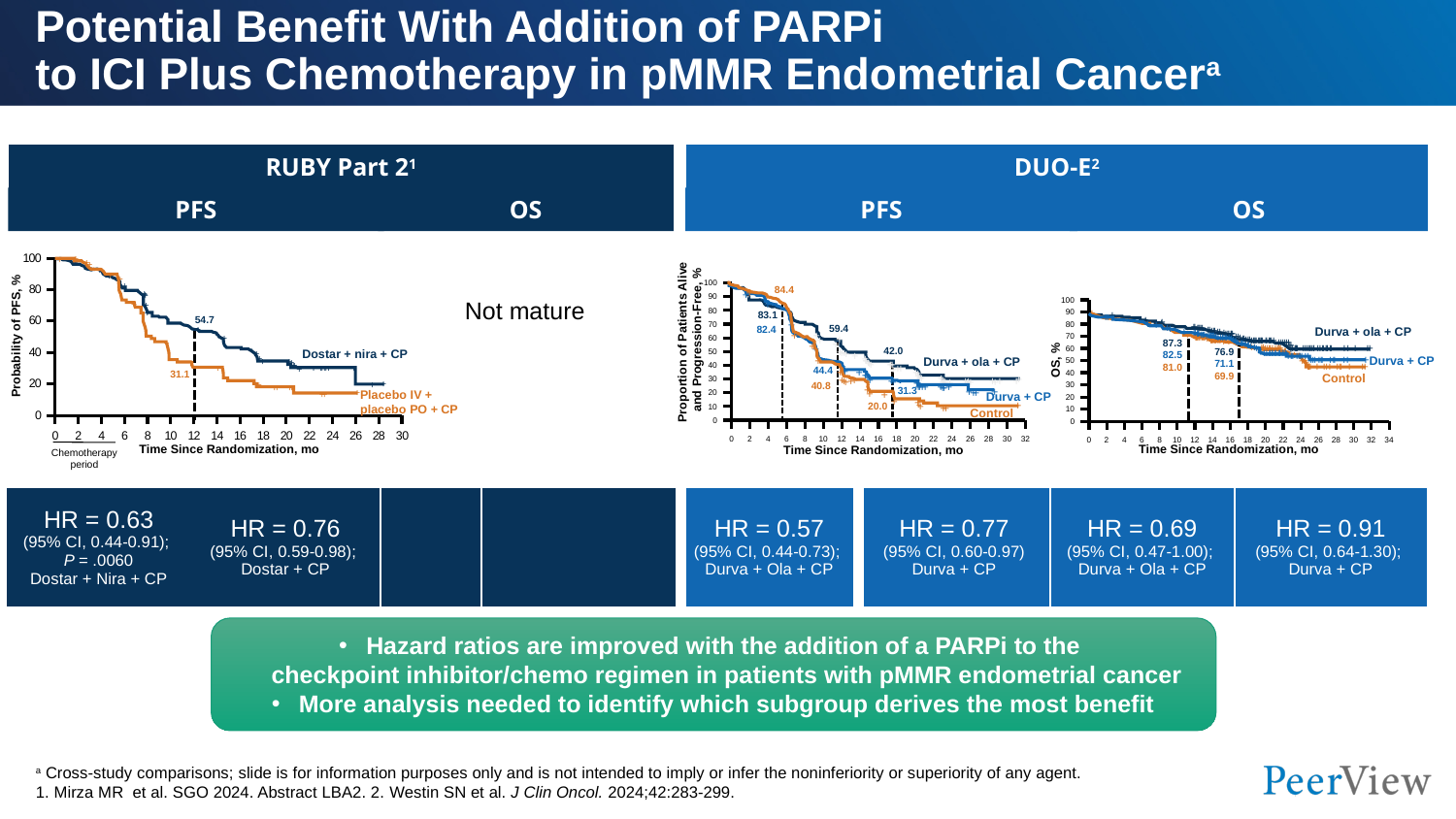
What is the x-axis label of the DUO-E OS chart? Time Since Randomization, mo In the RUBY Part 2 PFS chart, what is the difference between the labeled values 54.7 and 31.1? 23.6 How many treatment arms are plotted in the DUO-E PFS chart? 3 In the DUO-E PFS chart, what is the labeled value for the Control arm at the 18-month dashed line? 20.0 What kind of chart is the RUBY Part 2 PFS chart? Line chart (Kaplan-Meier curve) In the DUO-E OS chart, what is the labeled OS value for the Control arm at the second dashed line? 69.9 In the RUBY Part 2 PFS chart, which arm has the higher labeled PFS value at the dashed line, Dostar + nira + CP or Placebo IV + placebo PO + CP? Dostar + nira + CP In the RUBY Part 2 PFS chart, what is the labeled probability of PFS for the Dostar + nira + CP arm at the dashed line? 54.7 In the DUO-E PFS chart, what is the difference between the Durva + ola + CP value (59.4) and the Control value (40.8) at the 12-month dashed line? 18.6 In the DUO-E OS chart, what is the labeled OS value for the Durva + ola + CP arm at the first dashed line? 87.3 In the RUBY Part 2 PFS chart, what is the labeled probability of PFS for the Placebo IV + placebo PO + CP arm at the dashed line? 31.1 In the DUO-E PFS chart, what is the labeled value for the Durva + ola + CP arm at the 12-month dashed line? 59.4